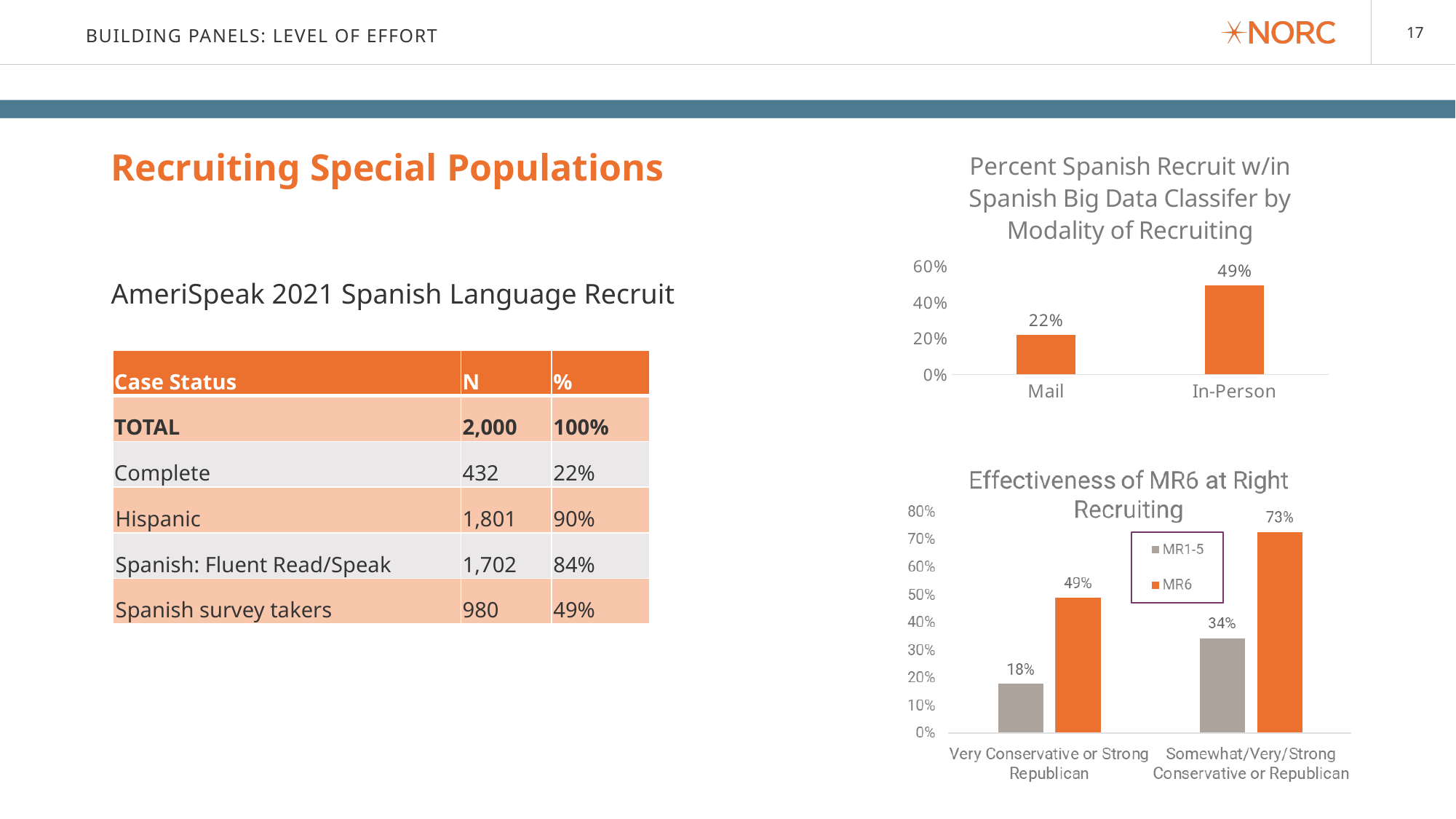
What kind of chart is the 'Effectiveness of MR6 at Right Recruiting' chart? Bar chart In the 'Percent Spanish Recruit w/in Spanish Big Data Classifer by Modality of Recruiting' chart, how many categories are shown on the x axis? 2 In the 'Effectiveness of MR6 at Right Recruiting' chart, how many series does the legend list? 2 In the 'Percent Spanish Recruit w/in Spanish Big Data Classifer by Modality of Recruiting' chart, what is the value for Mail? 22% In the 'Effectiveness of MR6 at Right Recruiting' chart, which is larger: the MR1-5 value for Very Conservative or Strong Republican or the MR1-5 value for Somewhat/Very/Strong Conservative or Republican? Somewhat/Very/Strong Conservative or Republican In the 'Effectiveness of MR6 at Right Recruiting' chart, what colour are the MR6 bars? Orange In the 'Effectiveness of MR6 at Right Recruiting' chart, what is the difference between the MR6 and MR1-5 values for Somewhat/Very/Strong Conservative or Republican? 39% In the 'Percent Spanish Recruit w/in Spanish Big Data Classifer by Modality of Recruiting' chart, which modality has the higher value? In-Person In the 'Percent Spanish Recruit w/in Spanish Big Data Classifer by Modality of Recruiting' chart, what is the difference between the In-Person and Mail values? 27% In the 'Effectiveness of MR6 at Right Recruiting' chart, what is the MR6 value for Very Conservative or Strong Republican? 49% In the 'Effectiveness of MR6 at Right Recruiting' chart, what is the MR1-5 value for Somewhat/Very/Strong Conservative or Republican? 34% In the 'Percent Spanish Recruit w/in Spanish Big Data Classifer by Modality of Recruiting' chart, what is the value for In-Person? 49%